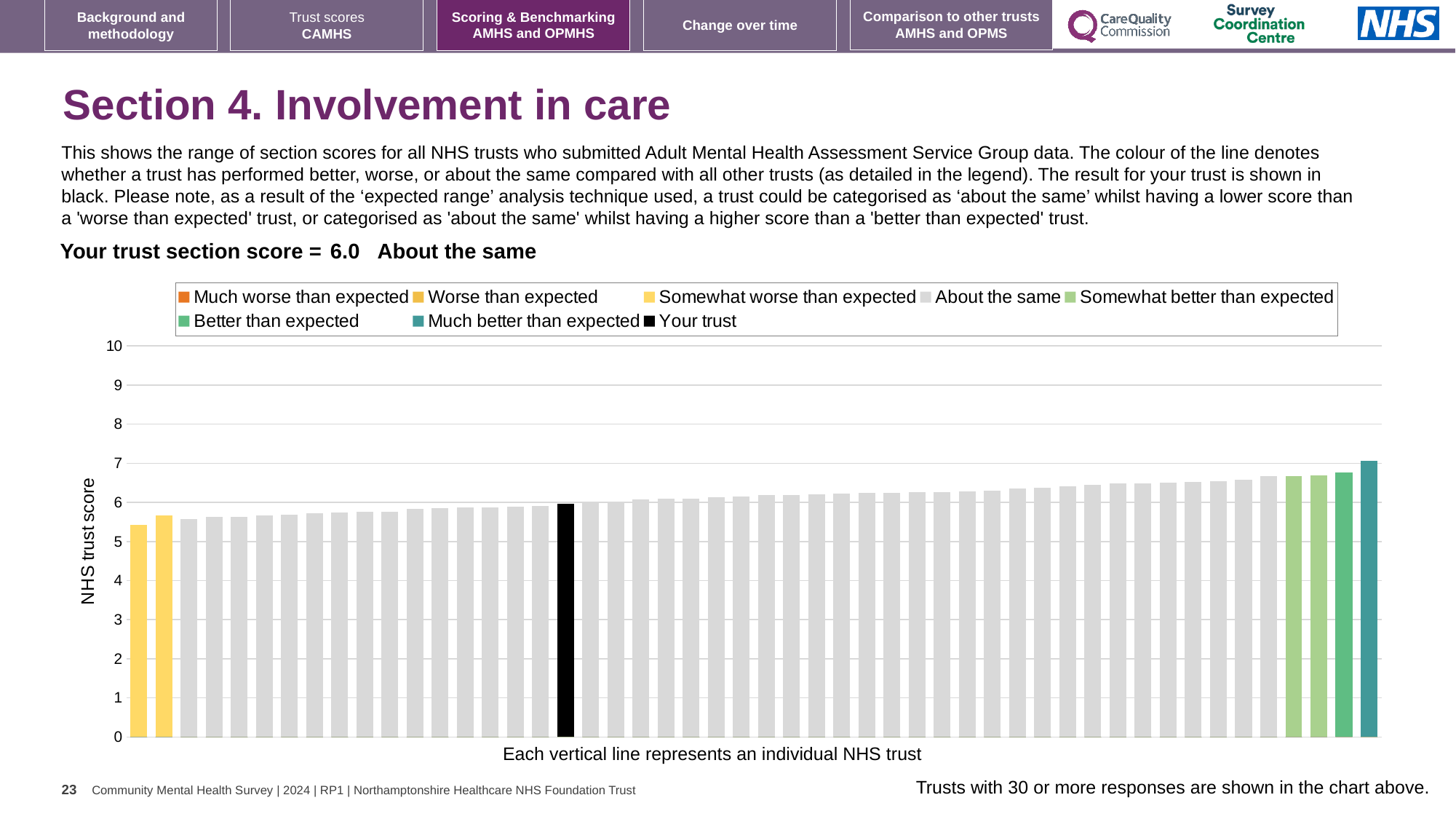
Do the bar values rise or fall from left to right along the x axis? rise Which is taller, the black 'Your trust' bar or the leftmost yellow bar? the black 'Your trust' bar Which category does your trust fall into according to the text above the chart? About the same Is the value of the black 'Your trust' bar greater or less than 5? greater Is the value of the shortest bar (leftmost) greater or less than 6? less What kind of chart is shown on the slide? bar chart What is the label on the vertical axis of the chart? NHS trust score Which legend category does the tallest bar belong to? Much better than expected What is the section score for your trust, as printed on the slide? 6.0 Is the value of the tallest bar (rightmost) greater or less than 6? greater How many entries does the chart legend list? 8